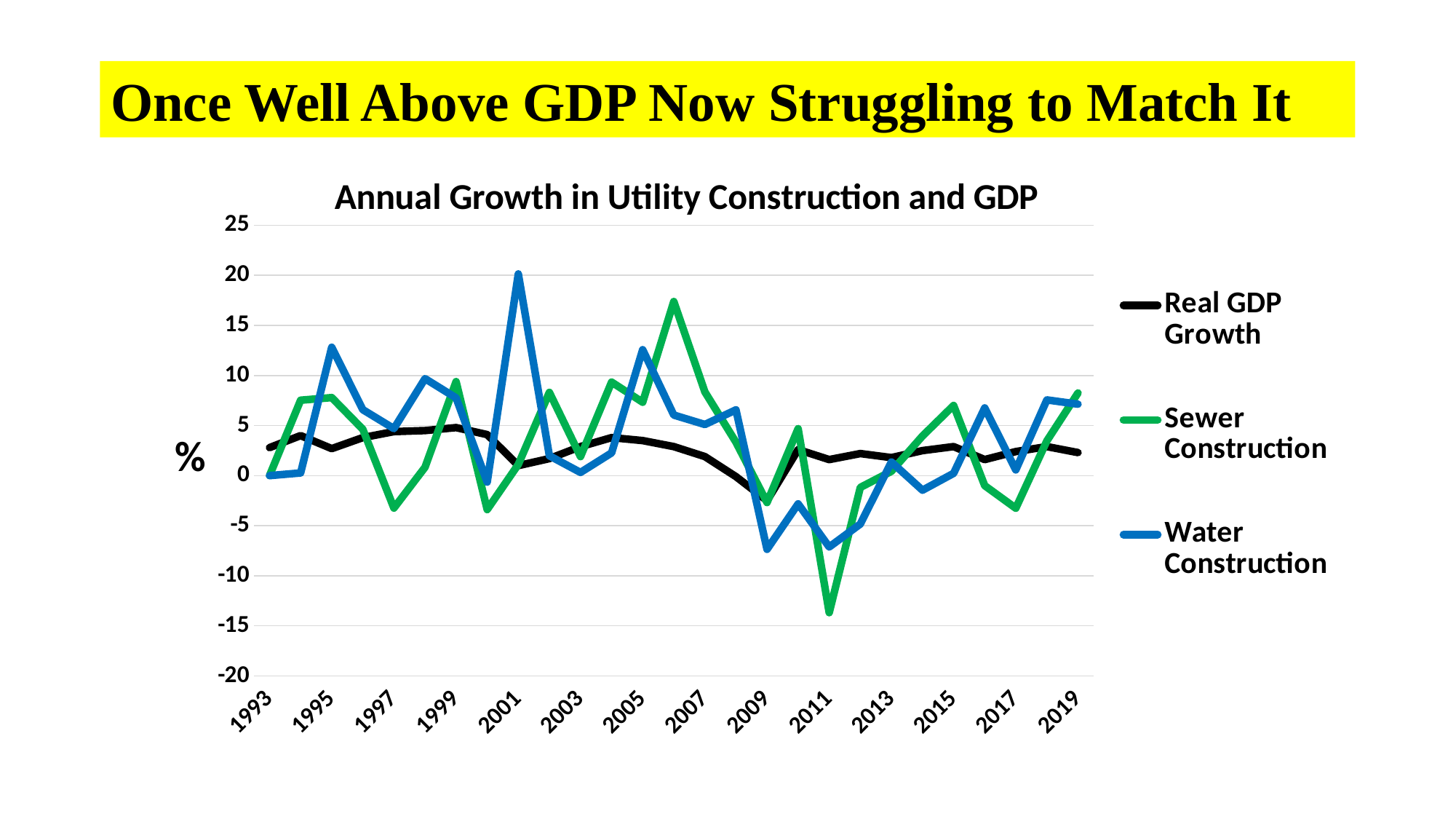
Is the value for Real GDP Growth in 2009 greater or less than 0? less Is the value for Sewer Construction in 2011 greater or less than -10? less What kind of chart is shown on the slide? line chart Which series is drawn in green? Sewer Construction How many series does the legend list? 3 Which series reaches the highest value anywhere on the chart? Water Construction Which series reaches the lowest value anywhere on the chart? Sewer Construction Is the value for Water Construction in 2001 greater or less than 15? greater In 2011, which is larger: Sewer Construction or Water Construction? Water Construction In 2001, which is larger: Water Construction or Real GDP Growth? Water Construction What is the title of the chart? Annual Growth in Utility Construction and GDP